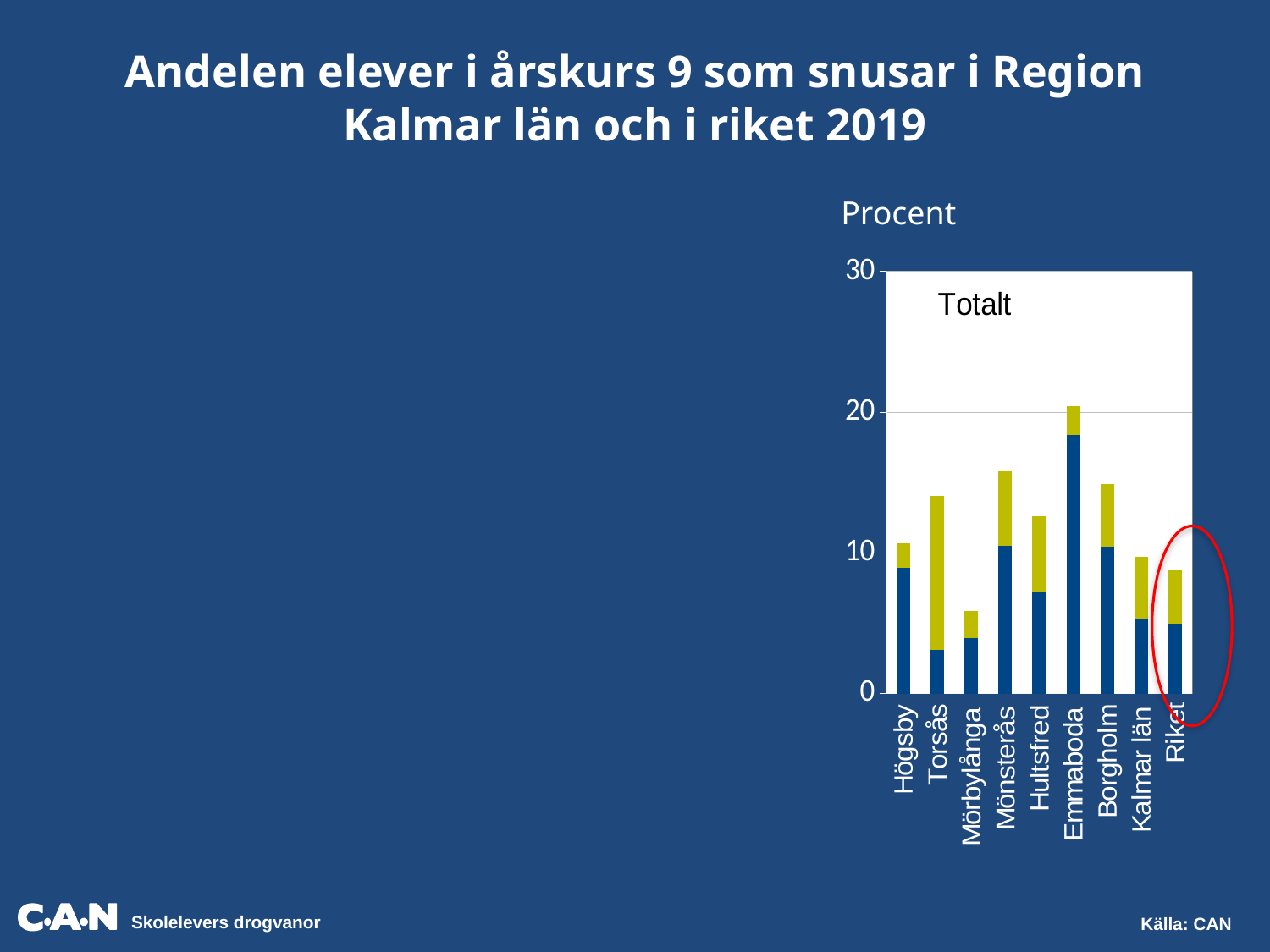
Is the total value for Mörbylånga greater or less than 10? less Is the total value for Mönsterås greater or less than 10? greater What unit is shown as the label above the y axis of the chart? Procent Is the total value for Torsås greater or less than 10? greater Which category has the highest total bar in the chart? Emmaboda Which has the larger total bar, Emmaboda or Mönsterås? Emmaboda Which category has the lowest total bar in the chart? Mörbylånga Which category's bar is circled in red on the chart? Riket What kind of chart is shown on the slide? Stacked bar chart How many categories are shown along the x axis of the chart? 9 Which has the larger total bar, Torsås or Hultsfred? Torsås